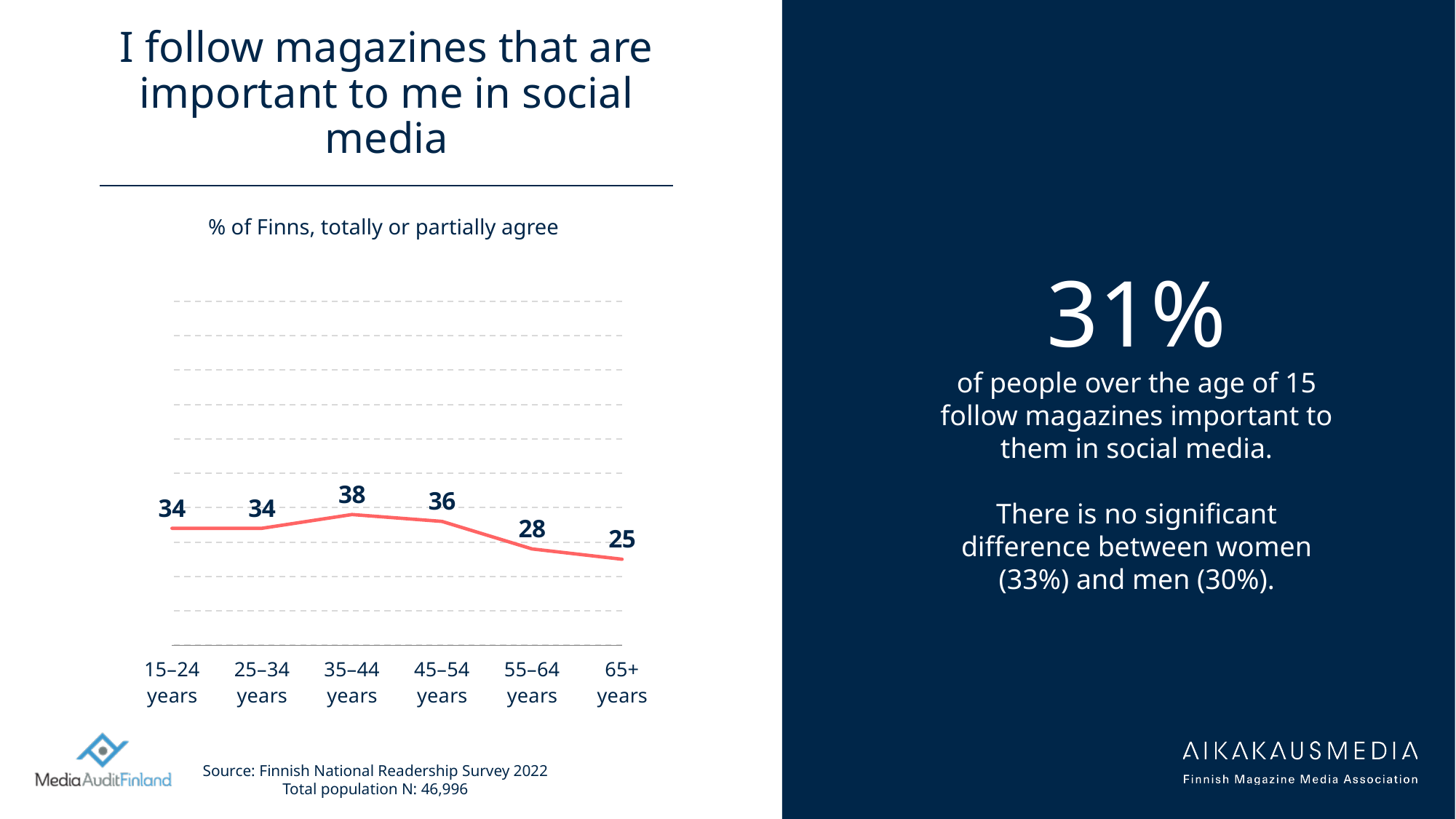
What is the value for 55–64 years? 28 What kind of chart is shown on the slide? line chart Which is larger, the value for 45–54 years or the value for 55–64 years? 45–54 years What is the value for 35–44 years? 38 Do the values rise or fall from 35–44 years to 65+ years? fall Which age group has the highest value? 35–44 years What is the difference between the values for 45–54 years and 55–64 years? 8 How many age groups are plotted on the chart? 6 What is the subtitle shown above the chart? % of Finns, totally or partially agree Which age group has the lowest value? 65+ years What is the value for 65+ years? 25 What is the difference between the values for 35–44 years and 65+ years? 13